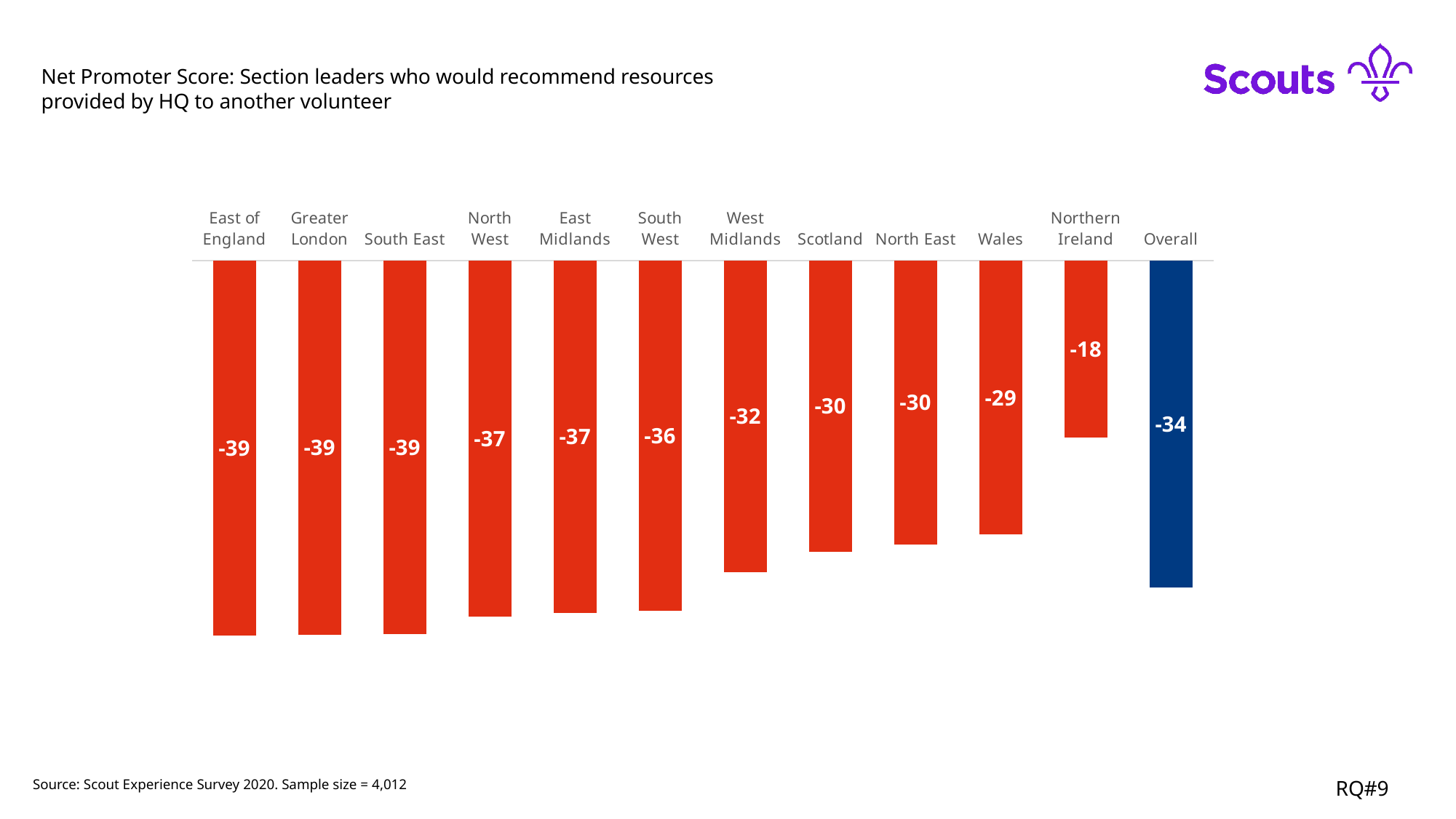
What is the value for West Midlands? -32 Which region has the highest (least negative) Net Promoter Score? Northern Ireland What is the difference between the Wales score and the East of England score? 10 What is the difference between the Northern Ireland score and the Overall score? 16 What is the value for South West? -36 What is the Overall Net Promoter Score shown on the chart? -34 What type of chart is shown on the slide? Bar chart Which bar is coloured blue rather than red? Overall How many bars are shown on the chart? 12 Which has the higher Net Promoter Score, Scotland or Wales? Wales Which has the higher Net Promoter Score, North West or West Midlands? West Midlands What is the Net Promoter Score for Northern Ireland? -18